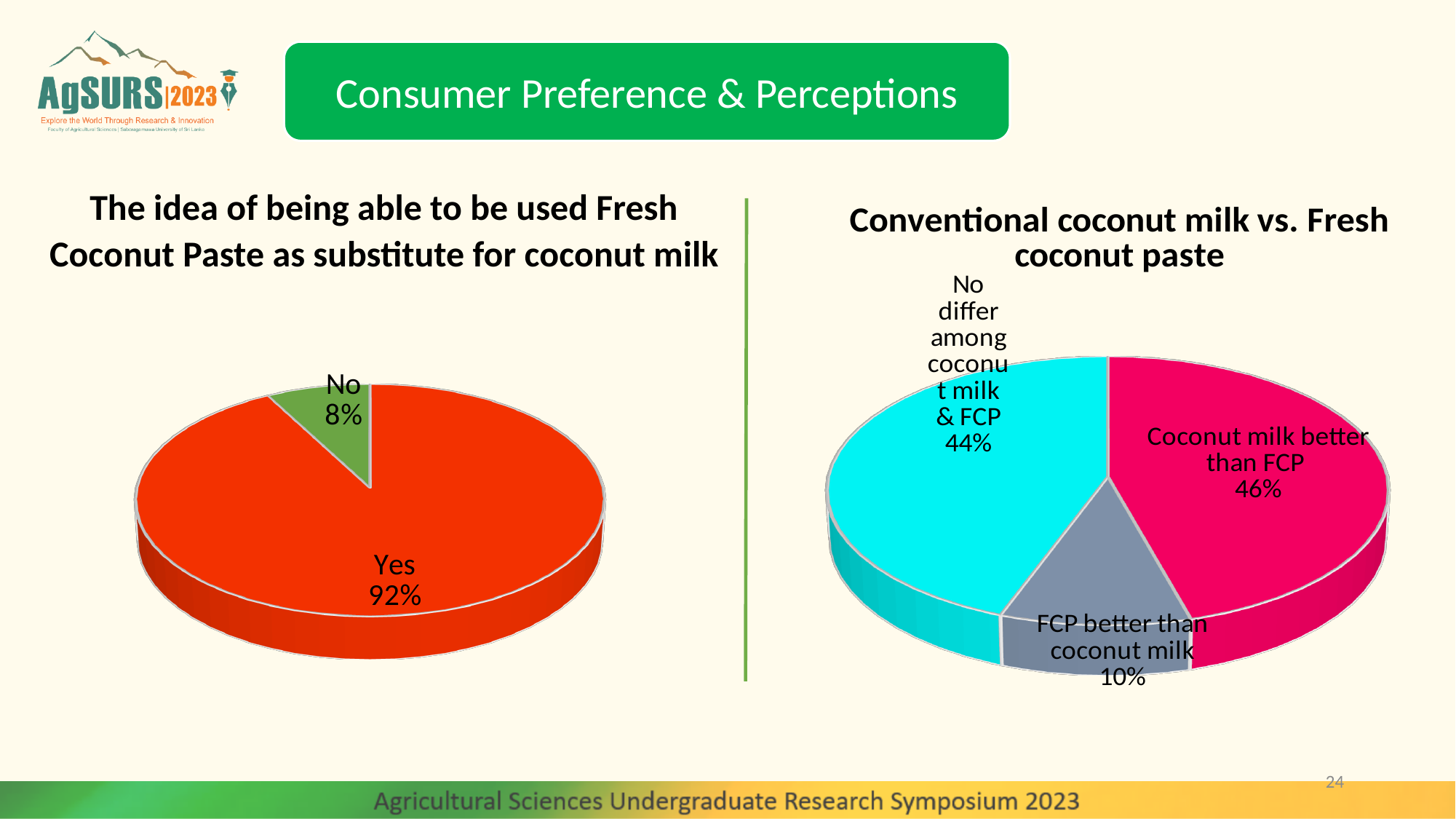
What type of chart is shown on the right side of the slide? Pie chart What is the title of the right pie chart? Conventional coconut milk vs. Fresh coconut paste In the left pie chart, what percentage of respondents answered No? 8% In the right pie chart, what is the difference between the 'Coconut milk better than FCP' share and the 'FCP better than coconut milk' share? 36% In the left pie chart, what percentage of respondents answered Yes? 92% In the left pie chart, which category has the largest share? Yes In the right pie chart, which category has the smallest share? FCP better than coconut milk In the right pie chart, what share says coconut milk is better than FCP? 46% In the left pie chart, what is the difference between the Yes and No shares? 84% How many slices does the left pie chart have? 2 In the right pie chart, what share reports no difference among coconut milk and FCP? 44% In the right pie chart, what share says FCP is better than coconut milk? 10%